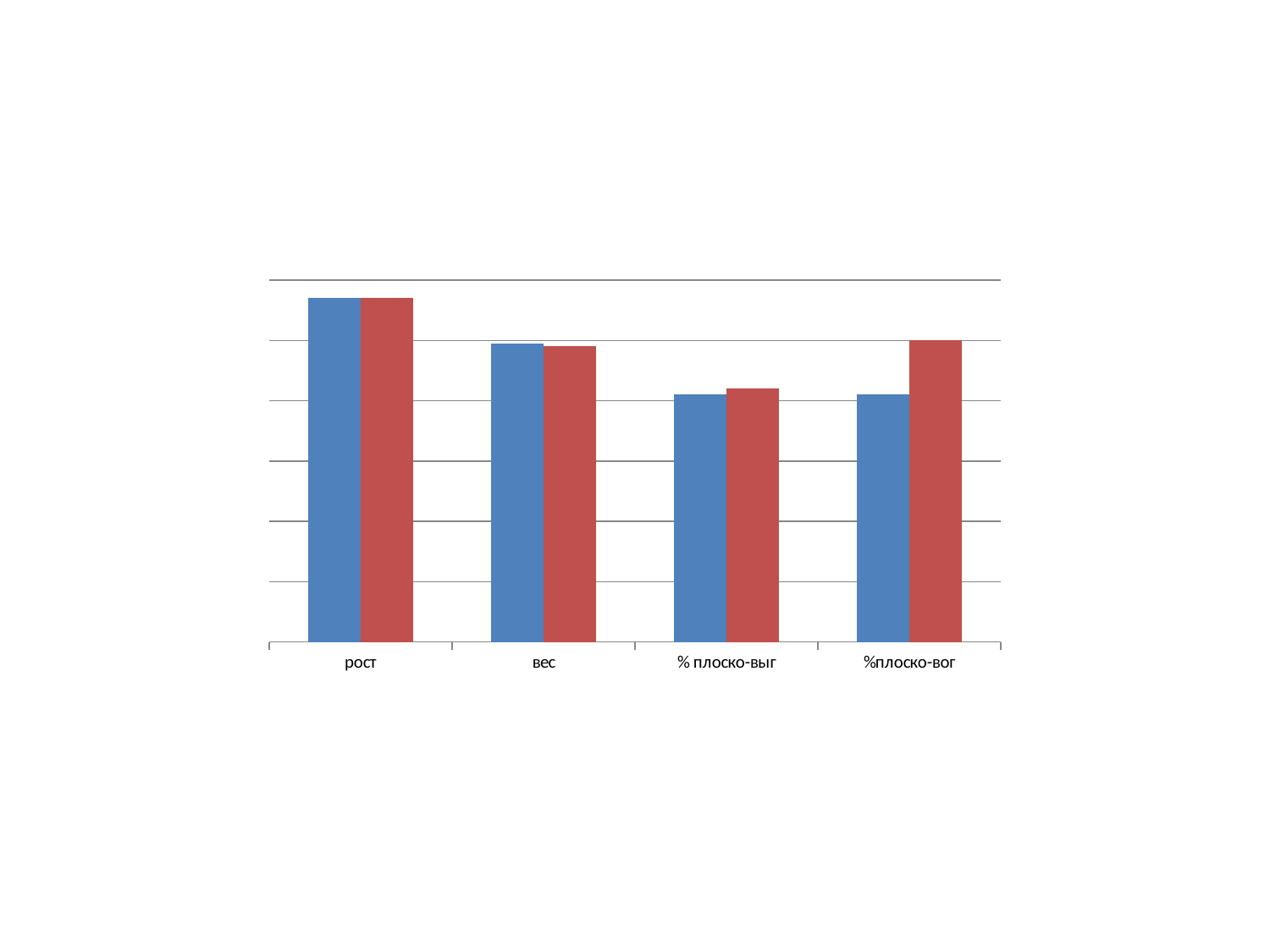
Which category has the tallest blue bar? рост For the category вес, which bar is taller, the blue one or the red one? blue How many categories are shown on the x axis? 4 For the category %плоско-вог, which bar is taller, the blue one or the red one? red Which is taller: the blue bar for рост or the blue bar for вес? рост How many data series are plotted in the chart? 2 What two colours are used for the bars in the chart? blue and red What is the label of the first category on the x axis? рост Which category has the shortest red bar? % плоско-выг Which category has the tallest red bar? рост What kind of chart is shown on the slide? bar chart